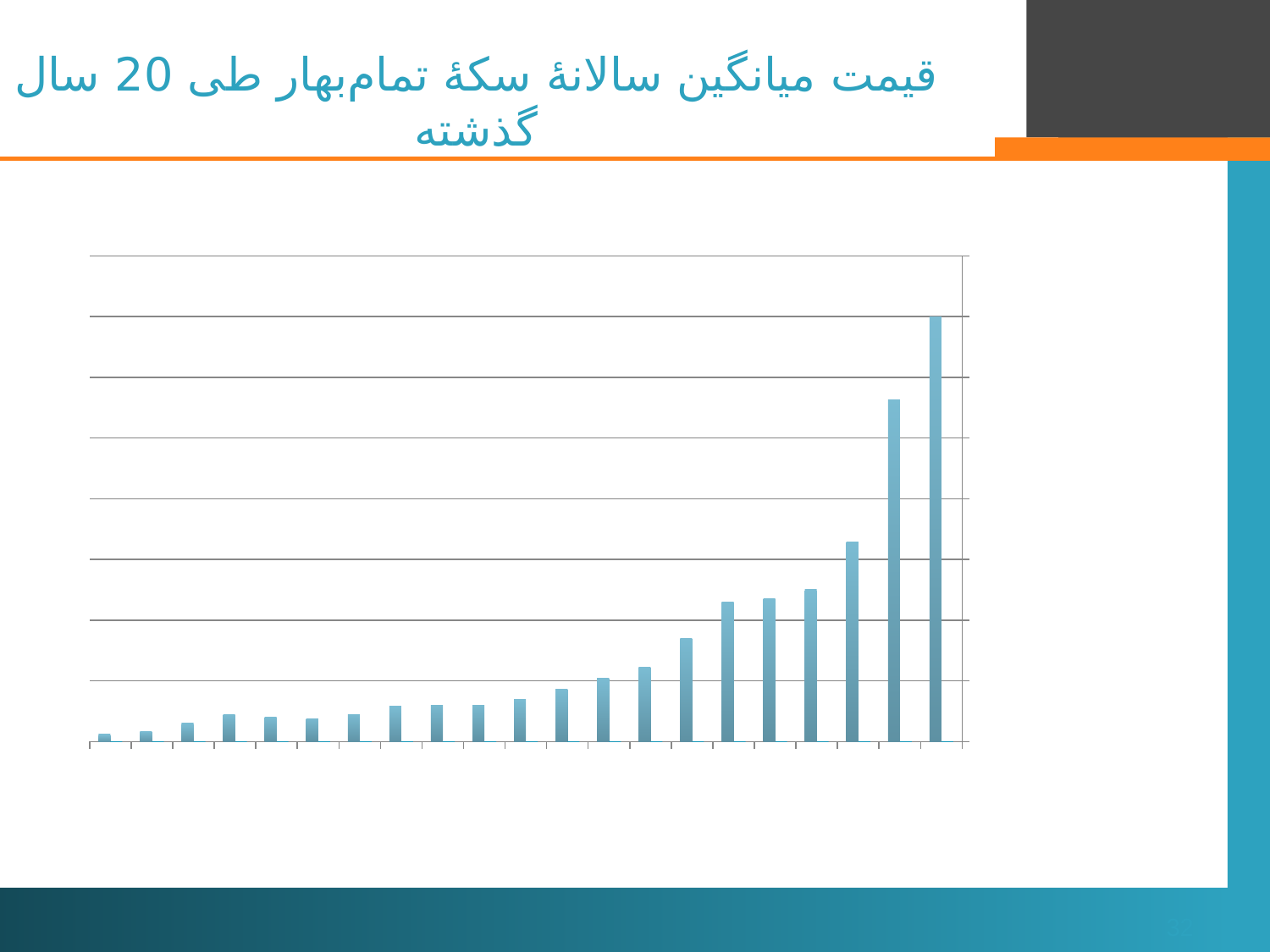
Do the bar values generally rise or fall from left to right along the x axis? rise Which is taller, the rightmost bar or the bar immediately to its left? the rightmost bar What colour are the bars in the chart? blue Which is taller, the leftmost bar or the rightmost bar? the rightmost bar Which bar is the shortest in the chart? the leftmost (first) bar What kind of chart is shown on the slide? bar chart Which bar is the tallest in the chart? the rightmost (last) bar How many bars are plotted in the chart? 21 What is the title of the slide containing the chart? قیمت میانگین سالانۀ سکۀ تمام‌بهار طی 20 سال گذشته